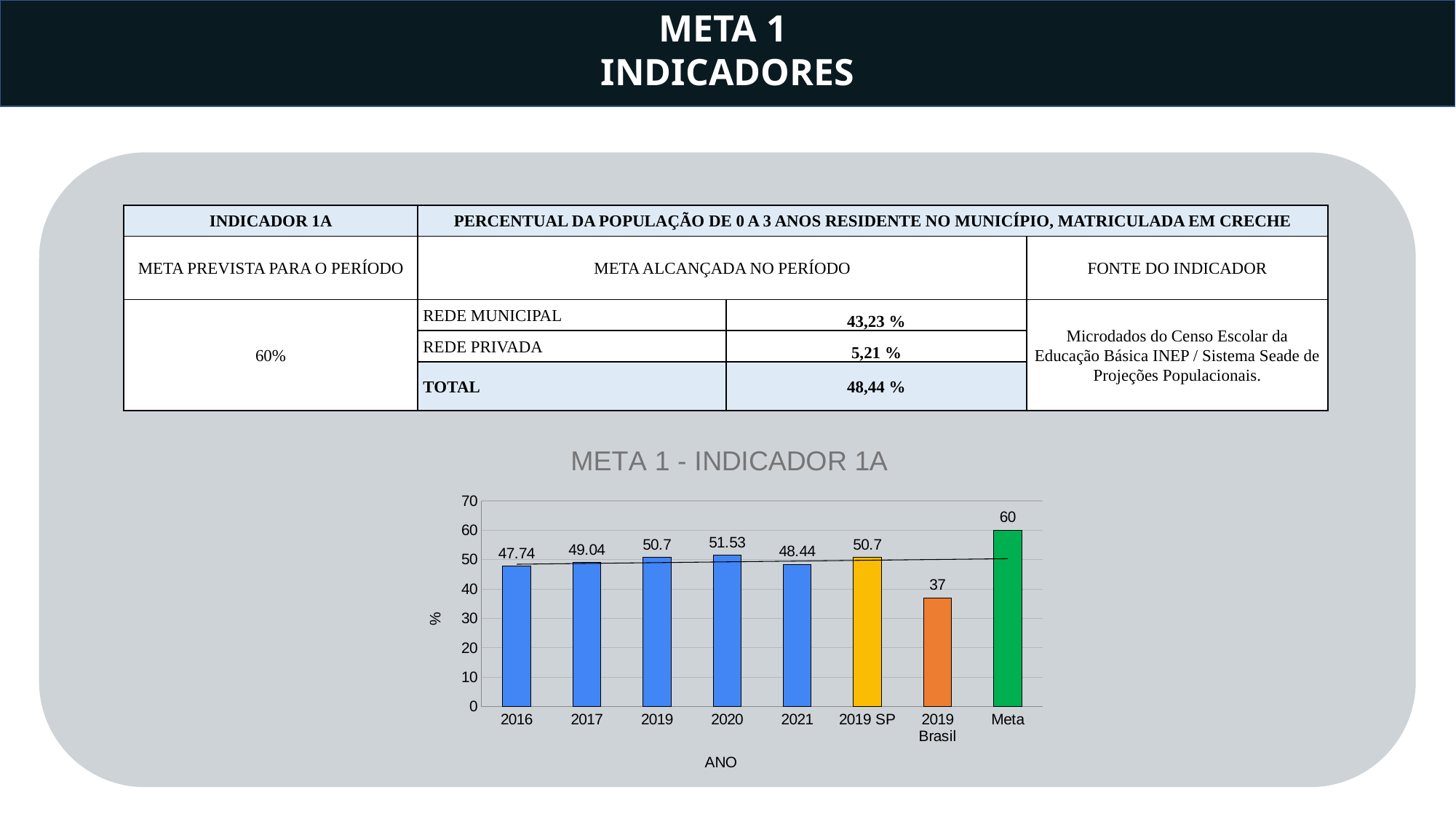
What kind of chart is shown on the slide? bar chart What is the difference between the Meta value and the 2021 value? 11.56 What is the value for 2020 in the chart? 51.53 What is the label of the x axis of the chart? ANO How many bars are shown in the chart? 8 Which category has the highest value in the chart? Meta Which is larger, the value for 2017 or the value for 2020? 2020 What is the value for 2019 Brasil in the chart? 37 Which category has the lowest value in the chart? 2019 Brasil Is the value for 2019 Brasil greater or less than 40? less What is the value for 2016 in the chart? 47.74 What is the title of the chart? META 1 - INDICADOR 1A